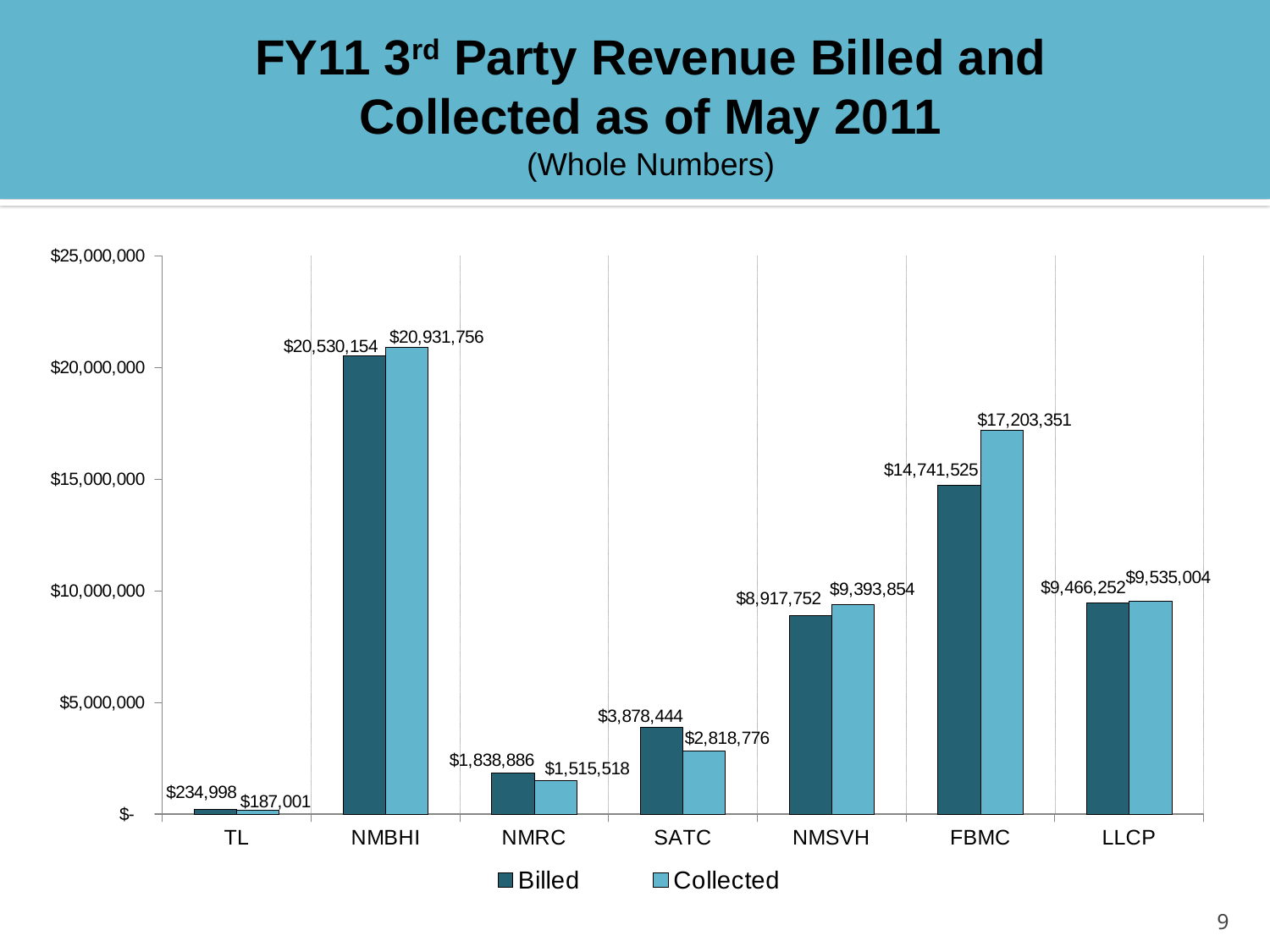
Is the Billed value for NMSVH greater or less than $10,000,000? less How many categories are shown on the x axis? 7 What kind of chart is shown on the slide? Bar chart What is the Collected value for FBMC? $17,203,351 What is the Collected value for TL? $187,001 Which category has the lowest Billed value? TL How much larger is the Collected value than the Billed value for FBMC? $2,461,826 How many series does the legend list? 2 Which category has the highest Collected value? NMBHI For SATC, which is larger: the Billed value or the Collected value? Billed What is the Billed value for SATC? $3,878,444 What is the Billed value for NMBHI? $20,530,154